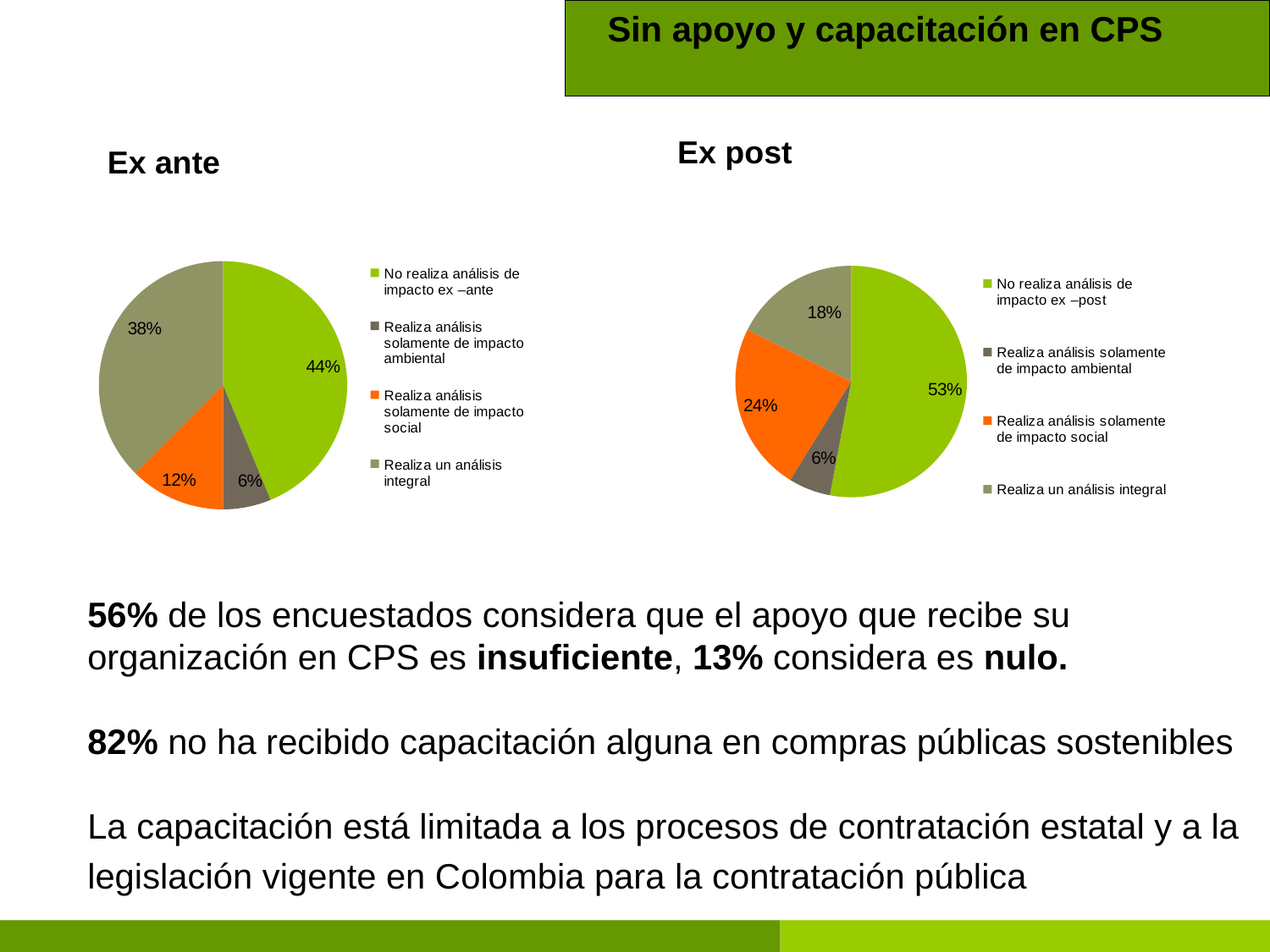
In the Ex post chart, what percentage corresponds to 'Realiza análisis solamente de impacto social'? 24% In the Ex ante chart, what percentage corresponds to 'Realiza un análisis integral'? 38% In the Ex post chart, what is the difference between the 'Realiza análisis solamente de impacto social' slice and the 'Realiza un análisis integral' slice? 6% What is the title of the green header box at the top of the slide? Sin apoyo y capacitación en CPS What type of chart is used for the Ex ante data? Pie chart How many categories does the Ex post pie chart show? 4 In the Ex ante chart, which category has the smallest slice? Realiza análisis solamente de impacto ambiental In the Ex ante chart, what share of respondents do not perform an ex-ante impact analysis (No realiza análisis de impacto ex –ante)? 44% Which chart has a larger share for 'Realiza un análisis integral', Ex ante or Ex post? Ex ante In the Ex post chart, which category has the largest slice? No realiza análisis de impacto ex –post In the Ex ante chart, what is the difference between the 'No realiza análisis de impacto ex –ante' slice and the 'Realiza un análisis integral' slice? 6% In the Ex post chart, what percentage corresponds to 'Realiza un análisis integral'? 18%